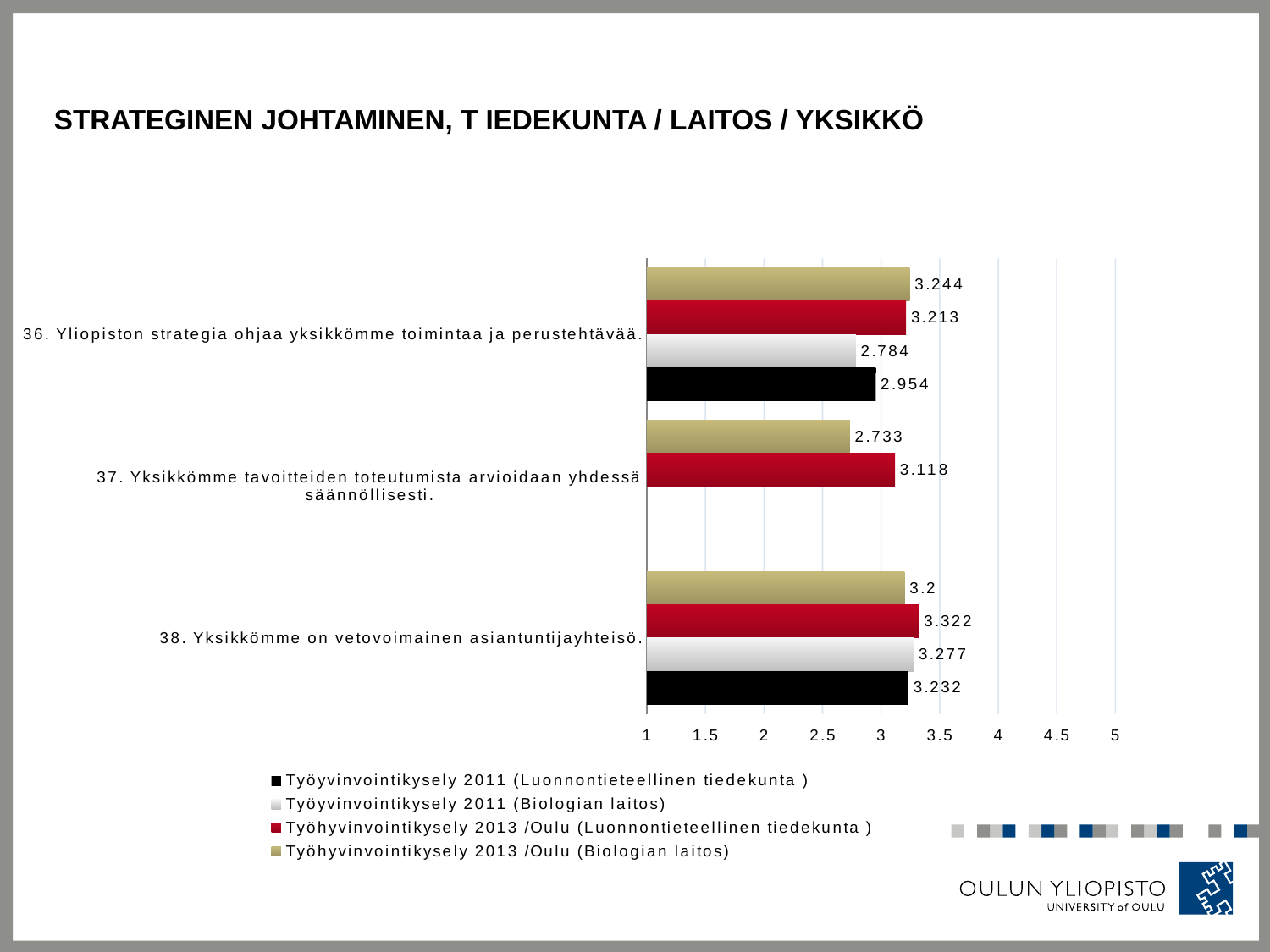
Which series has the lowest value for statement 36? Työyvinvointikysely 2011 (Biologian laitos) Which series has the highest value for statement 38? Työhyvinvointikysely 2013 /Oulu (Luonnontieteellinen tiedekunta) Is the value for statement 37 in the Työhyvinvointikysely 2013 /Oulu (Biologian laitos) series greater or less than 3? less What is the value for statement 36 in the Työhyvinvointikysely 2013 /Oulu (Biologian laitos) series? 3.244 What kind of chart is shown on the slide? bar chart What is the difference between the two 2013 /Oulu values for statement 37? 0.385 How many series does the legend list? 4 For statement 36, which is larger: the 2011 Luonnontieteellinen tiedekunta value or the 2011 Biologian laitos value? 2011 Luonnontieteellinen tiedekunta (2.954) How many categories (statements) are shown on the y axis? 3 What is the value for statement 37 in the Työhyvinvointikysely 2013 /Oulu (Luonnontieteellinen tiedekunta) series? 3.118 Which statement has no bars for the 2011 series? 37. Yksikkömme tavoitteiden toteutumista arvioidaan yhdessä säännöllisesti. What is the value for statement 38 in the Työyvinvointikysely 2011 (Biologian laitos) series? 3.277